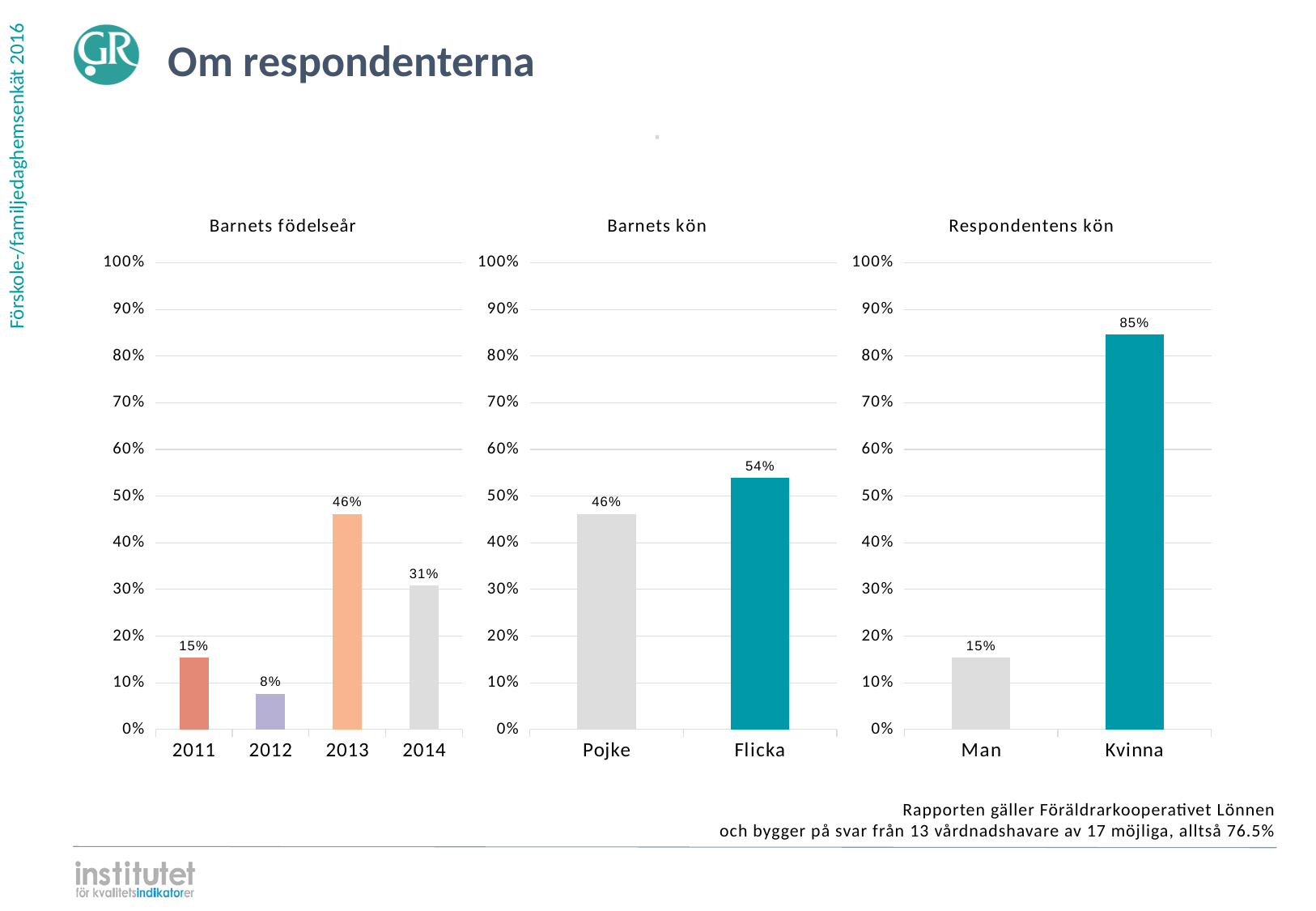
In the 'Barnets födelseår' chart, what is the value for 2013? 46% In the 'Barnets födelseår' chart, which year has the lowest value? 2012 What kind of chart is the 'Respondentens kön' chart? Bar chart In the 'Barnets födelseår' chart, which year has the highest value? 2013 In the 'Barnets kön' chart, what is the value for Pojke? 46% In the 'Respondentens kön' chart, what is the value for Kvinna? 85% How many charts are shown on the slide? 3 In the 'Barnets kön' chart, which is larger, Pojke or Flicka? Flicka In the 'Barnets födelseår' chart, what is the difference between the values for 2014 and 2011? 16% In the 'Barnets födelseår' chart, how many years are shown on the x axis? 4 In the 'Barnets kön' chart, what is the difference between Flicka and Pojke? 8% In the 'Respondentens kön' chart, what is the difference between Kvinna and Man? 70%